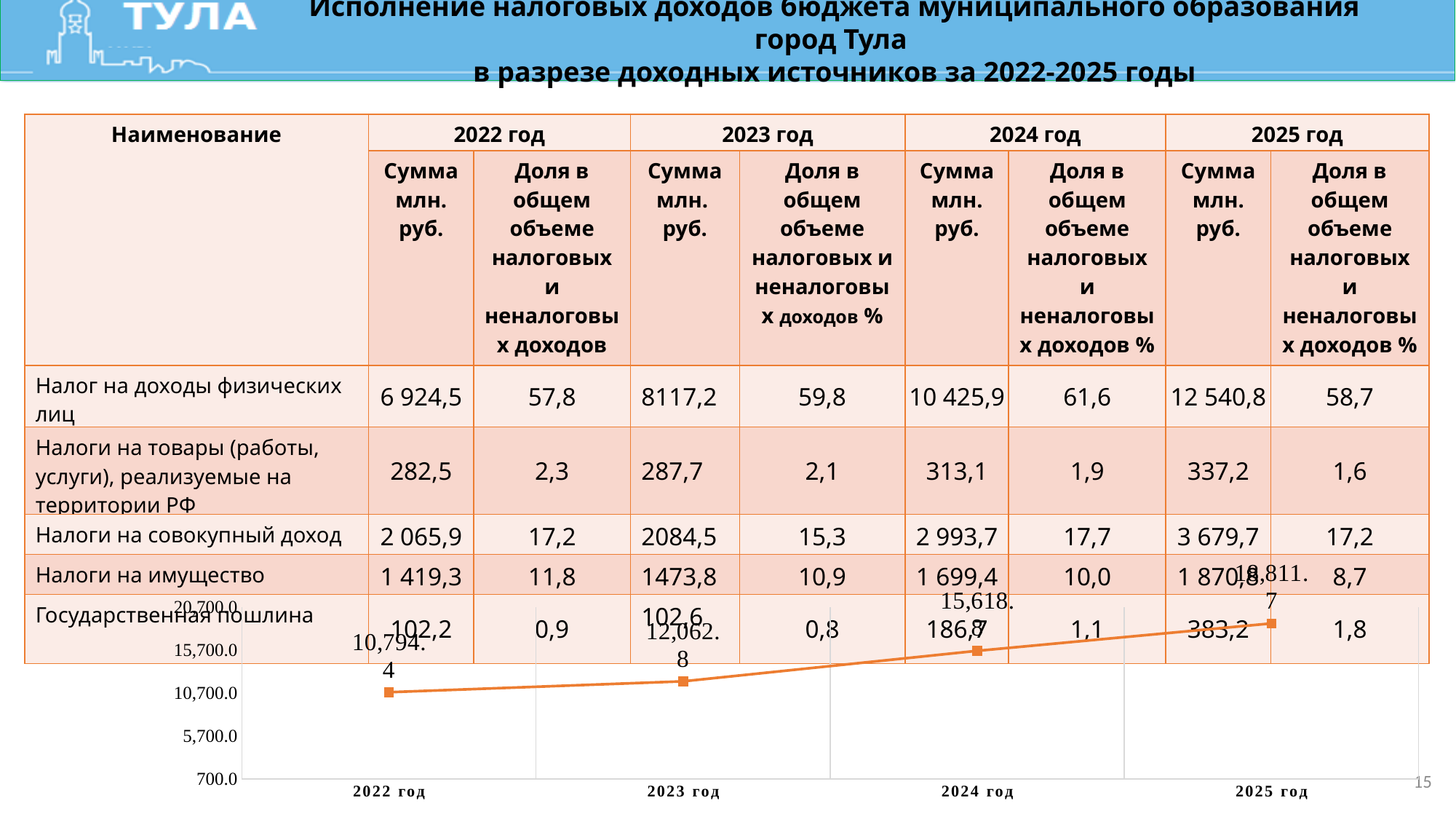
Do the values on the line chart rise or fall from 2022 год to 2025 год? rise What is the value plotted for 2022 год on the line chart? 10,794.4 What is the value plotted for 2023 год on the line chart? 12,062.8 What is the value plotted for 2025 год on the line chart? 18,811.7 Which year has the lowest value on the line chart? 2022 год On the line chart, is the value for 2024 год greater or less than 15,700.0? less Which year has the highest value on the line chart? 2025 год On the line chart, is the value for 2025 год greater or less than 15,700.0? greater What is the difference between the 2025 год and 2022 год values on the line chart? 8,017.3 How many data points are plotted on the line chart? 4 What kind of chart is shown at the bottom of the slide? line chart What is the value plotted for 2024 год on the line chart? 15,618.8